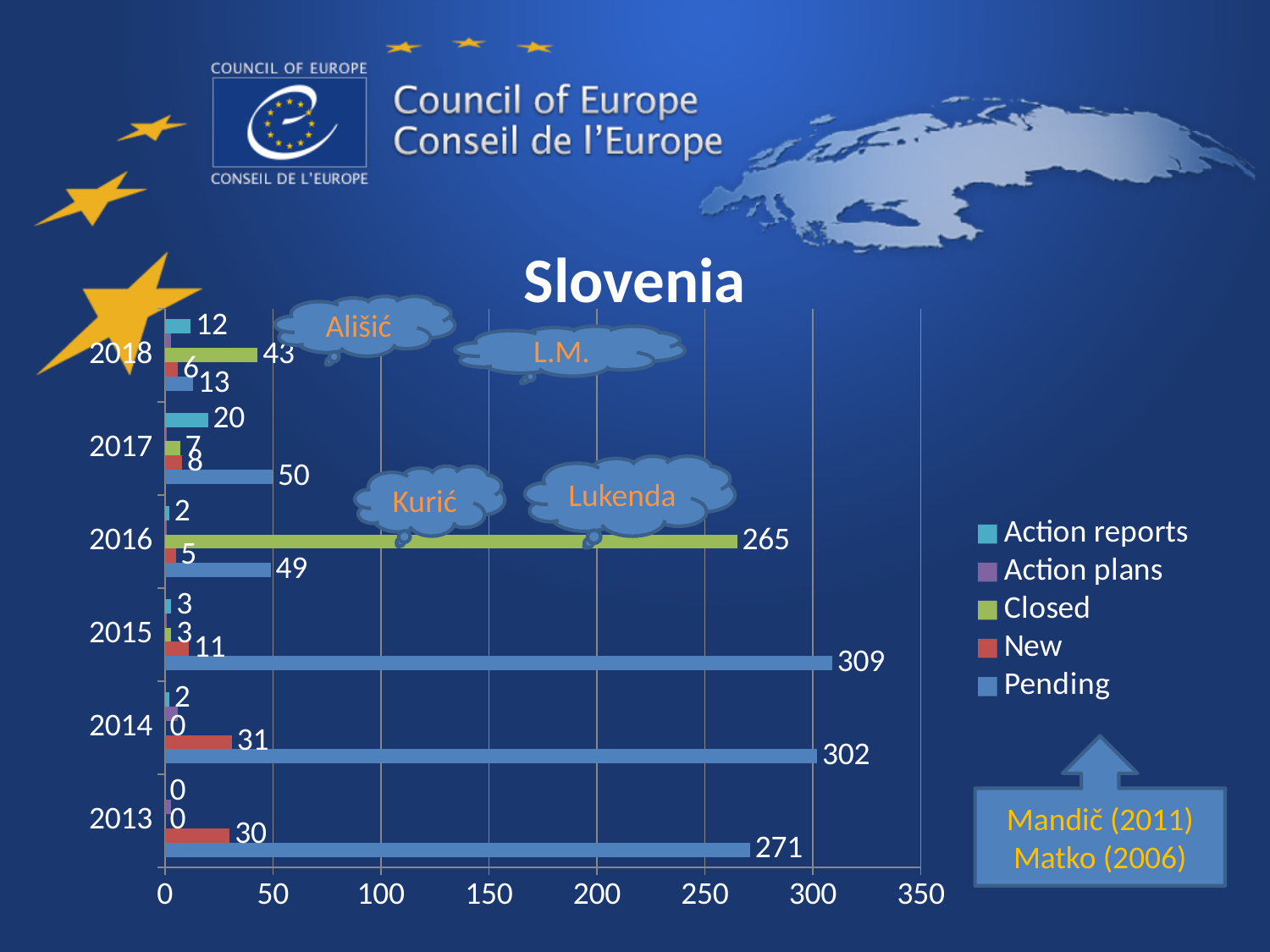
What is the Pending value for 2015? 309 What is the New value for 2014? 31 Which year has the lowest Pending value? 2018 How many years are shown on the chart? 6 What is the difference between the Pending values for 2015 and 2014? 7 What kind of chart is shown on the slide? Bar chart What is the Pending value for 2013? 271 What is the Closed value for 2016? 265 What is the Action reports value for 2017? 20 How many series does the legend list? 5 For 2016, which is larger: the Closed value or the Pending value? Closed Which year has the highest Pending value? 2015